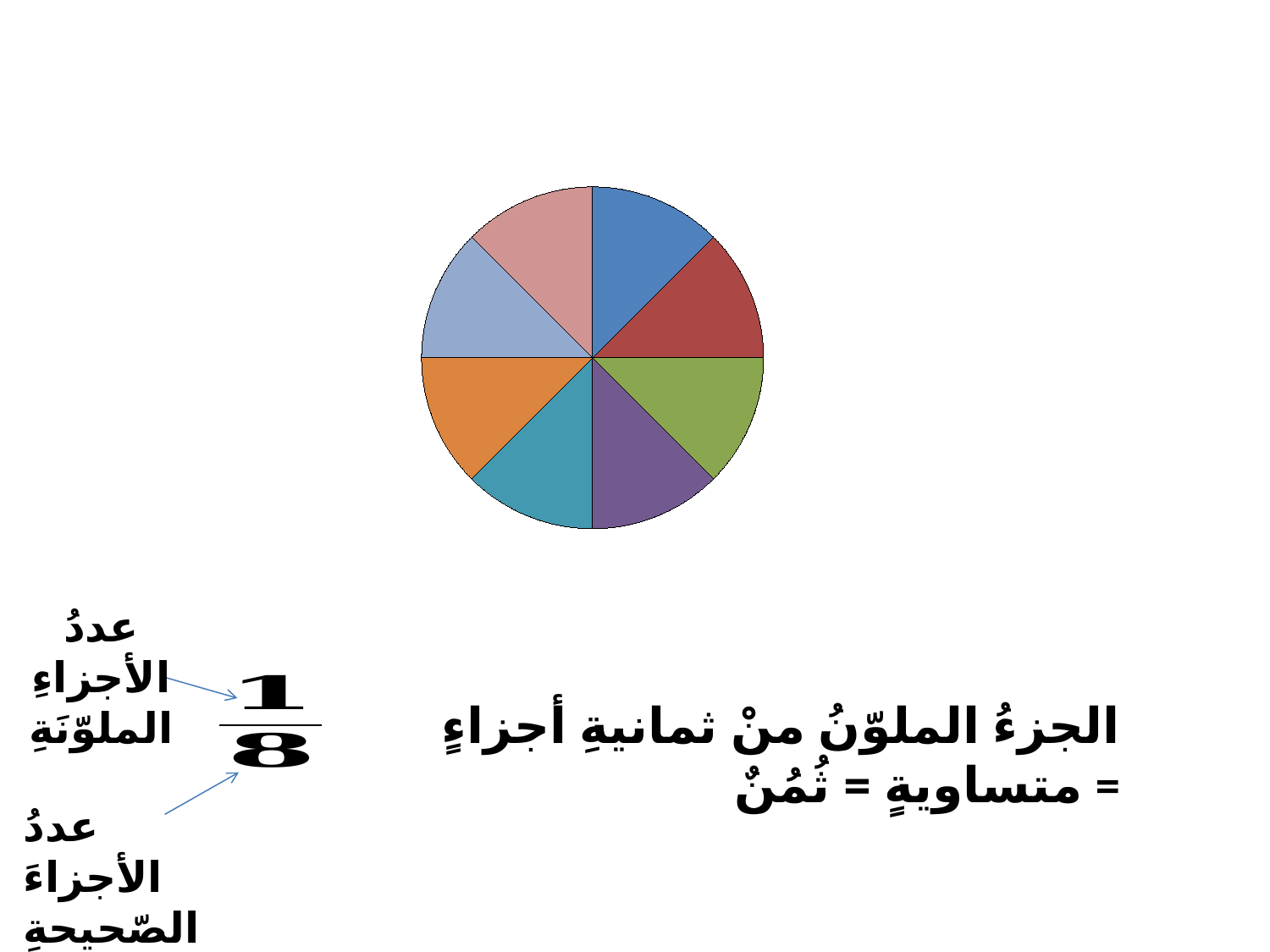
How many slices does the pie chart have? 8 Does the pie chart have a legend? No Are the slices of the pie chart equal in size? Yes According to the fraction printed on the slide, what share of the pie does one slice represent? 1/8 What kind of chart is shown on the slide? pie chart